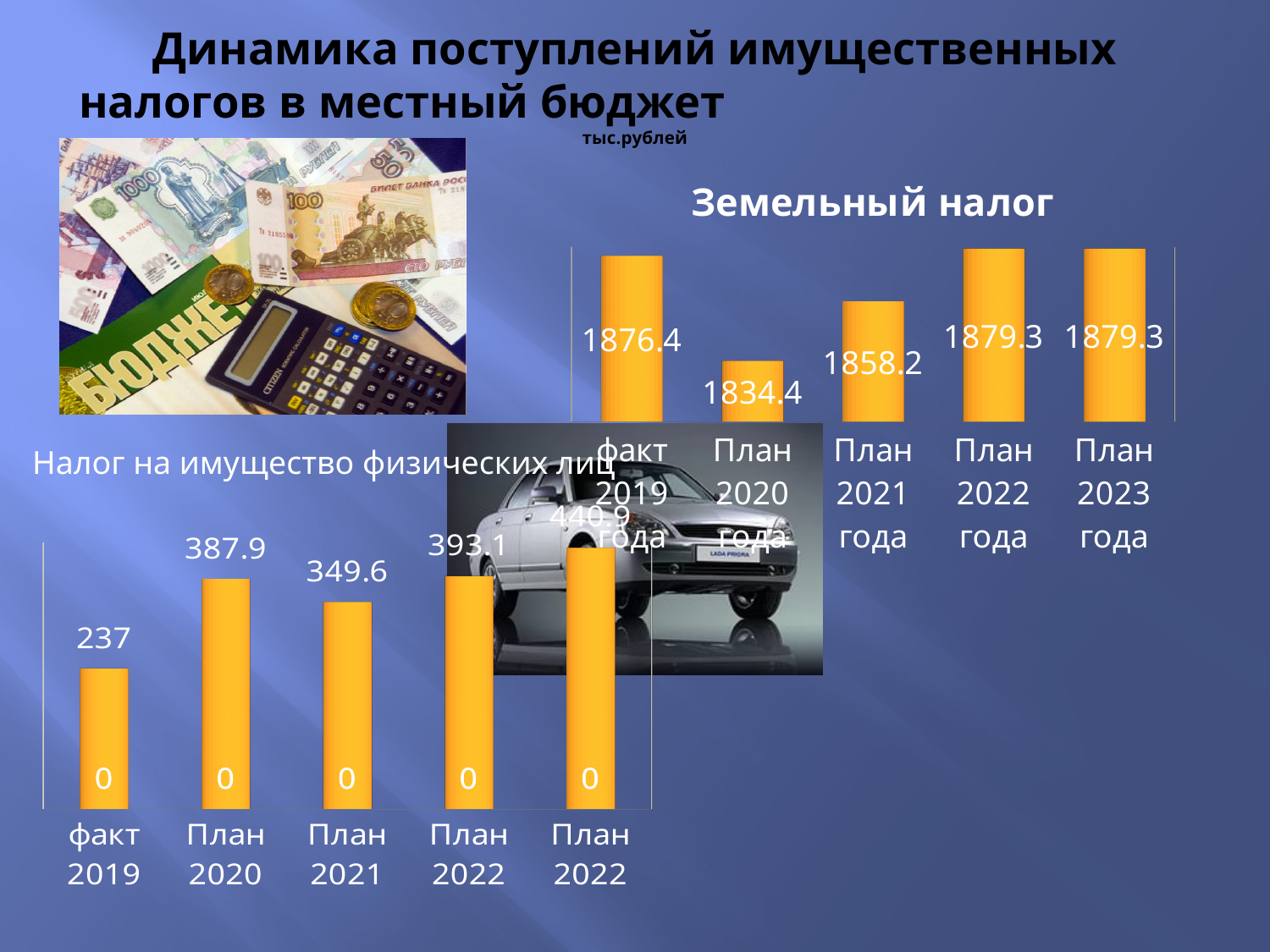
On the 'Налог на имущество физических лиц' chart, which category has the lowest value? факт 2019 On the 'Налог на имущество физических лиц' chart, what is the value for План 2021? 349.6 On the 'Земельный налог' chart, which is larger: План 2021 года or План 2022 года? План 2022 года On the 'Налог на имущество физических лиц' chart, what is the value for факт 2019? 237 What type of chart is the 'Земельный налог' chart? Bar chart On the 'Налог на имущество физических лиц' chart, what is the value of the last (rightmost) bar? 440.9 On the 'Налог на имущество физических лиц' chart, what is the difference between План 2020 and факт 2019? 150.9 On the 'Земельный налог' chart, what is the difference between факт 2019 года and План 2020 года? 42.0 On the 'Земельный налог' chart, what is the value for План 2021 года? 1858.2 How many bars are shown on the 'Земельный налог' chart? 5 On the 'Земельный налог' chart, what is the value for факт 2019 года? 1876.4 On the 'Земельный налог' chart, which category has the lowest value? План 2020 года